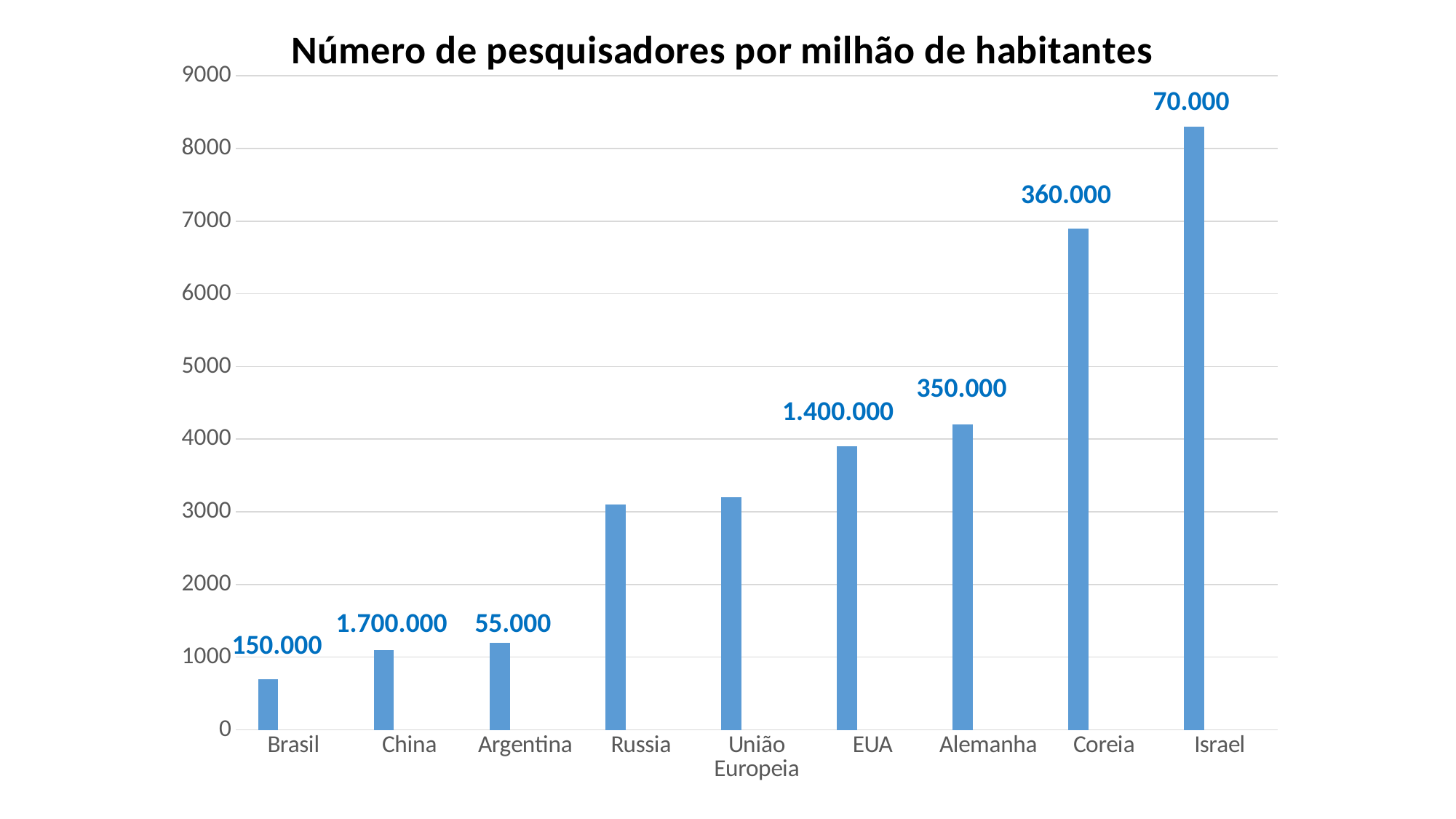
Is the value for Brasil greater or less than 1000? less What kind of chart is shown on the slide? bar chart Is the value for Israel greater or less than 8000? greater Which has a higher value, Alemanha or EUA? Alemanha Do the bar values generally rise or fall from left to right along the x axis? rise Which category has the highest bar in the chart? Israel How many countries or regions are shown on the x axis of the chart? 9 What is the title of the chart? Número de pesquisadores por milhão de habitantes Which has a higher value, Israel or Coreia? Israel Is the value for Alemanha greater or less than 4000? greater Which category has the lowest bar in the chart? Brasil